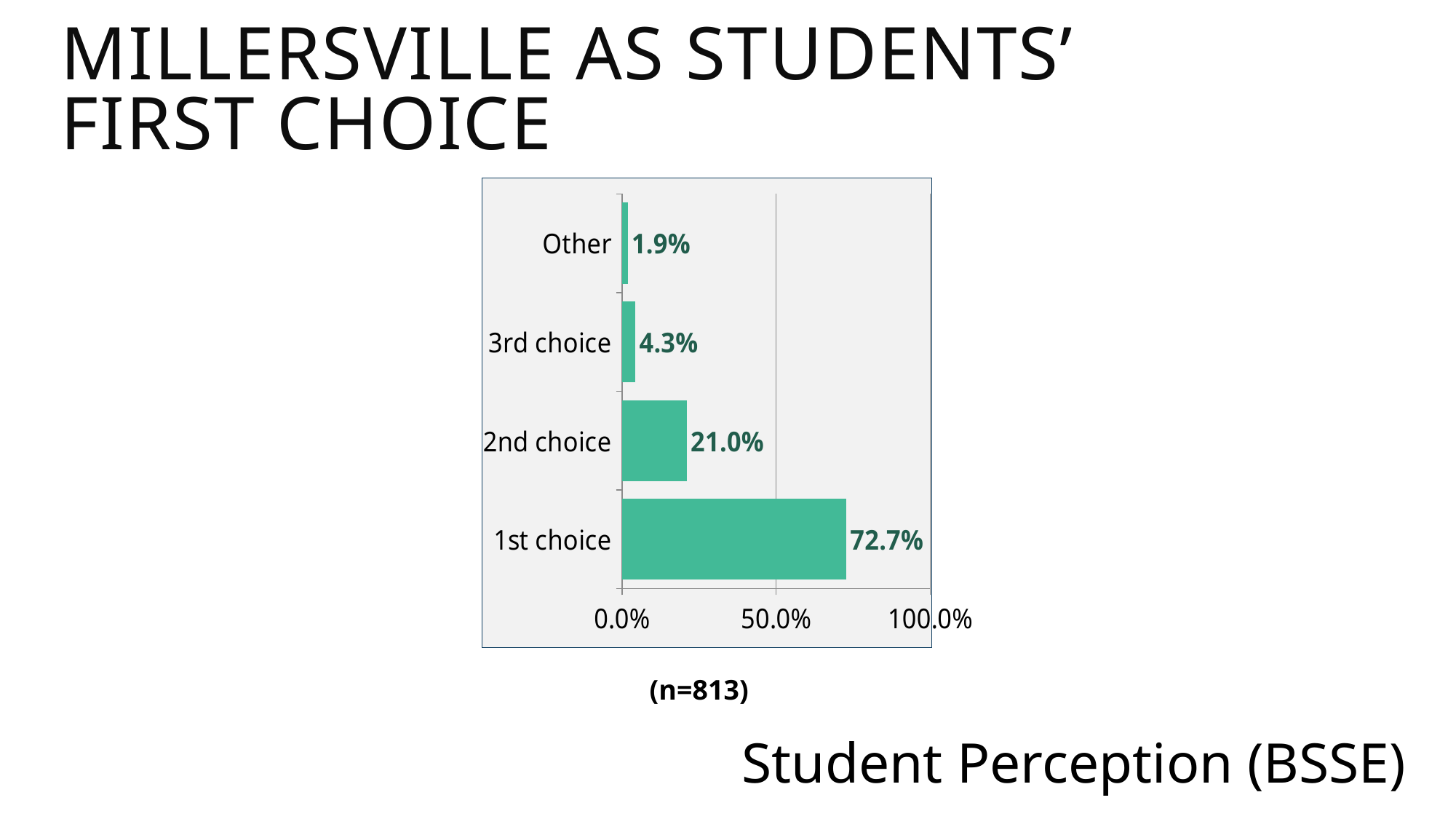
What is the difference between the 3rd choice and Other values? 2.4% What is the value shown for 3rd choice? 4.3% What is the difference between the 1st choice and 2nd choice values? 51.7% What kind of chart is shown on the slide? bar chart Which category has the lowest value? Other Which category has the highest value? 1st choice How many categories are shown in the chart? 4 Is the value for 1st choice greater or less than 50.0%? greater What is the value shown for 2nd choice? 21.0% What percentage of students said Millersville was their 1st choice? 72.7% What is the value shown for the Other category? 1.9% Which is larger, the value for 2nd choice or the value for 3rd choice? 2nd choice